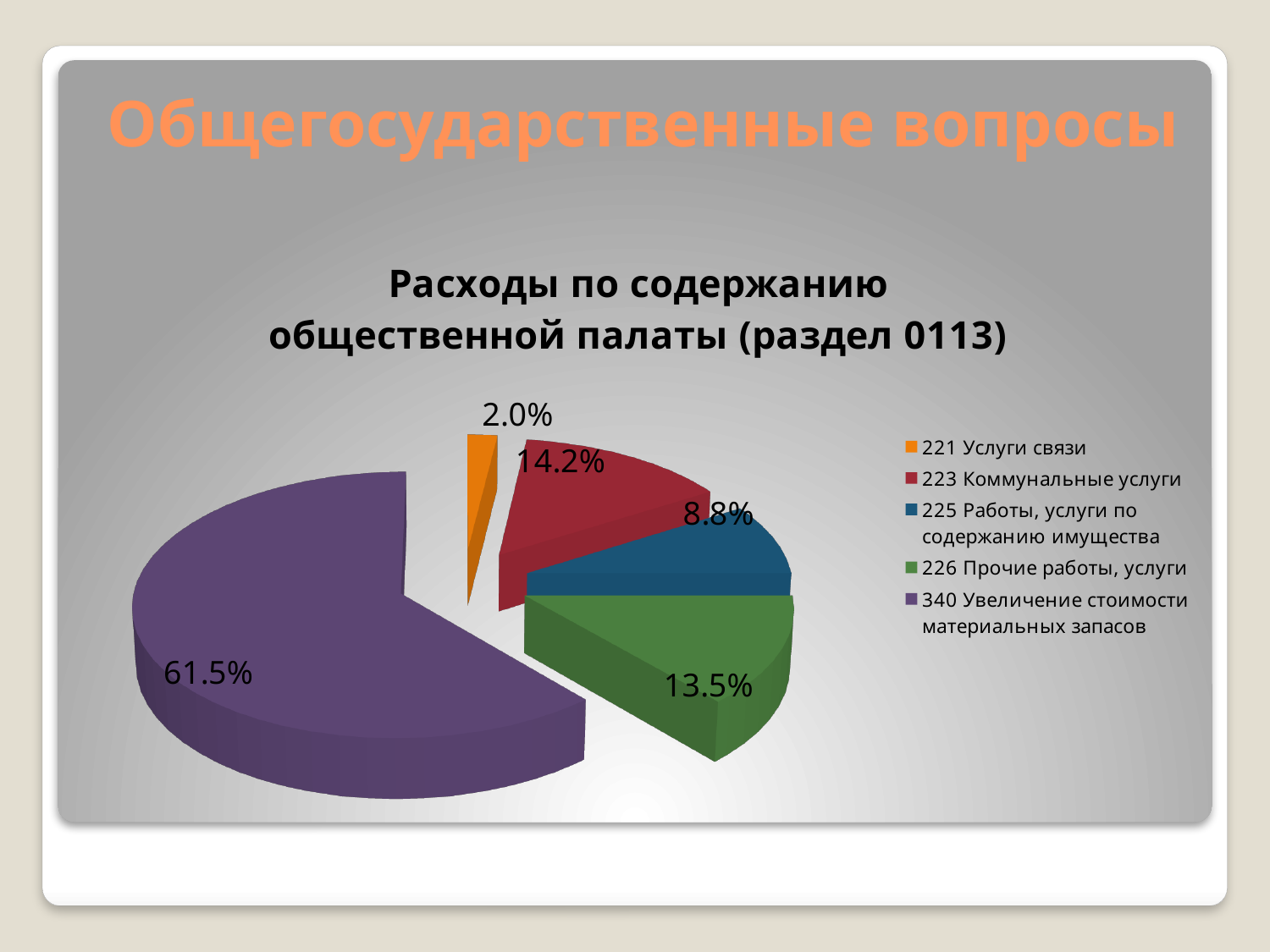
What kind of chart is shown on the slide? Pie chart What share of the pie does "223 Коммунальные услуги" have? 14.2% What share of the pie does "221 Услуги связи" have? 2.0% What is the difference in percentage points between the share for "340 Увеличение стоимости материальных запасов" and the share for "223 Коммунальные услуги"? 47.3 What share of the pie does "226 Прочие работы, услуги" have? 13.5% Which is larger: the share for "223 Коммунальные услуги" or the share for "225 Работы, услуги по содержанию имущества"? 223 Коммунальные услуги How many categories does the pie chart have? 5 Which category has the smallest share of the pie? 221 Услуги связи What is the title of the chart? Расходы по содержанию общественной палаты (раздел 0113) Which category has the largest share of the pie? 340 Увеличение стоимости материальных запасов What share of the pie does "225 Работы, услуги по содержанию имущества" have? 8.8% What share of the pie does "340 Увеличение стоимости материальных запасов" have? 61.5%